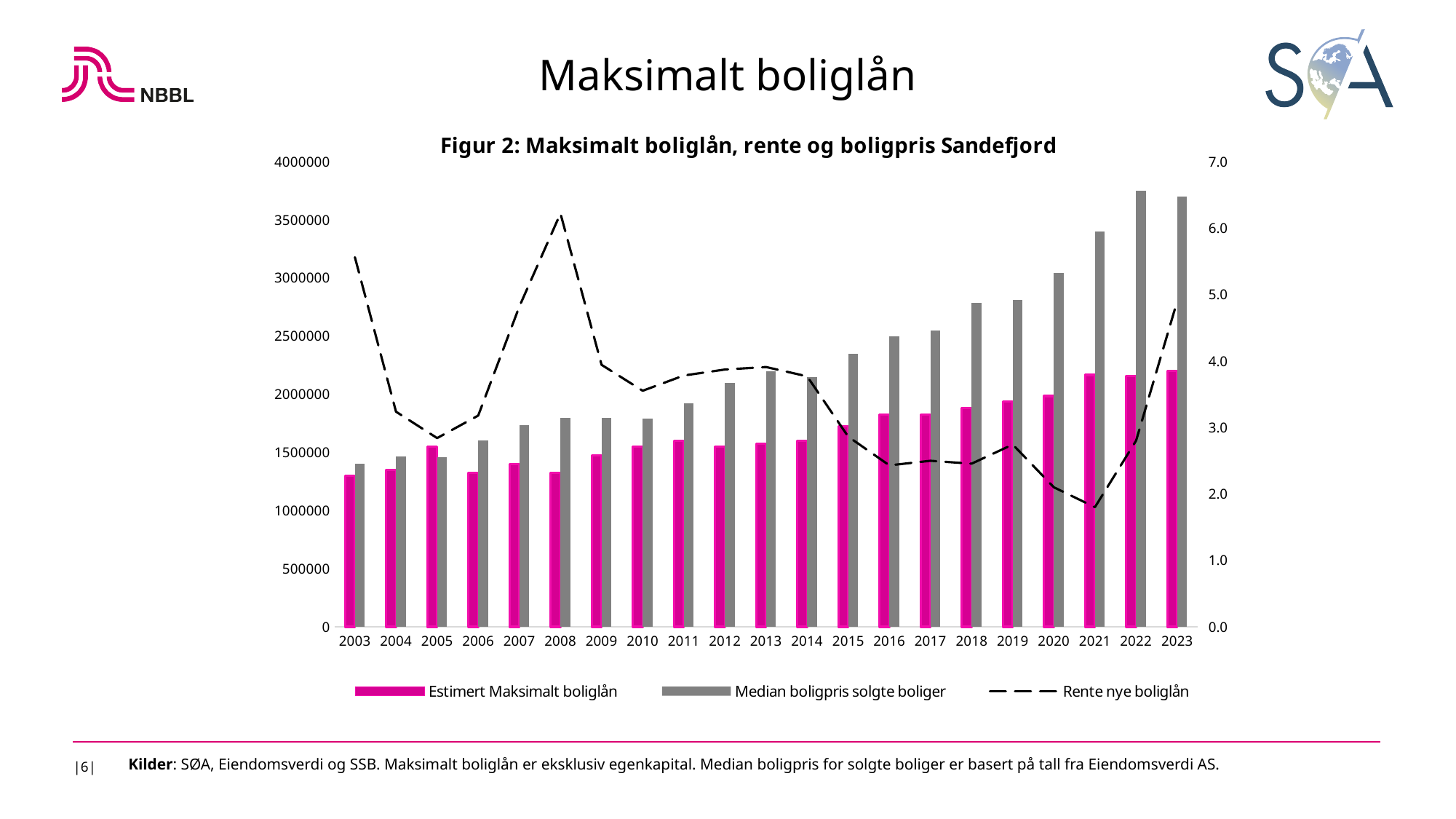
What kind of chart is shown on the slide? A combined bar and line chart In which year is 'Median boligpris solgte boliger' highest? 2022 How many years are shown on the x axis of the chart? 21 How many series does the chart's legend list? 3 In which year is the 'Rente nye boliglån' line at its highest? 2008 Is the value for 'Rente nye boliglån' in 2003 greater or less than 5.0? greater In 2023, which is larger: 'Estimert Maksimalt boliglån' or 'Median boligpris solgte boliger'? Median boligpris solgte boliger Is the value for 'Median boligpris solgte boliger' in 2021 greater or less than 3000000? greater What is the title of the chart? Figur 2: Maksimalt boliglån, rente og boligpris Sandefjord Is the value for 'Estimert Maksimalt boliglån' in 2023 greater or less than 2000000? greater Does 'Median boligpris solgte boliger' generally rise or fall from 2003 to 2023? Rise In which year is the 'Rente nye boliglån' line at its lowest? 2021